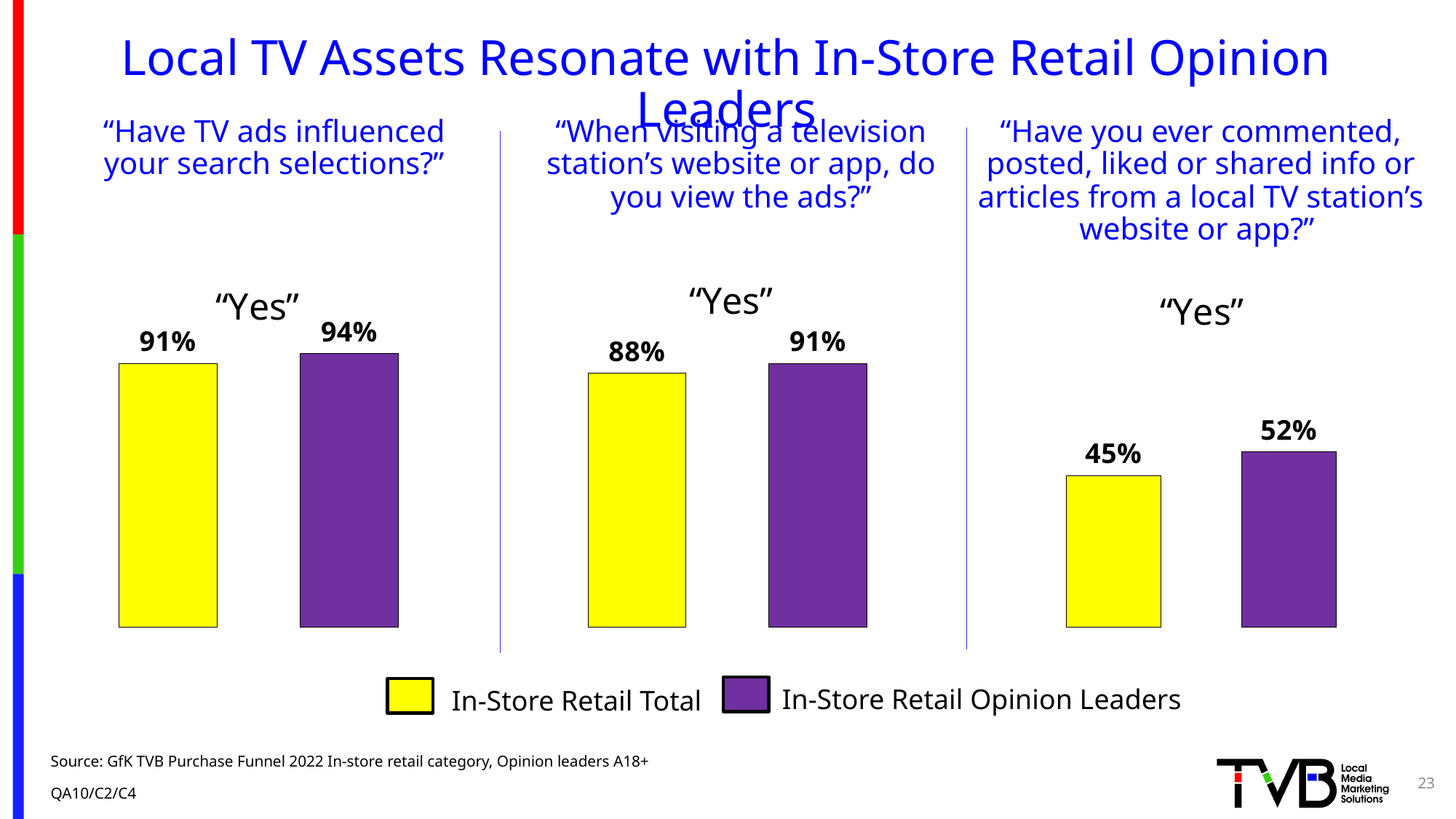
What kind of chart is used on this slide? Bar chart How many series does the legend list? 2 In the right chart ("Have you ever commented, posted, liked or shared info or articles from a local TV station's website or app?"), what is the value for In-Store Retail Opinion Leaders? 52% In the middle chart ("When visiting a television station's website or app, do you view the ads?"), which series has the larger value, In-Store Retail Total or In-Store Retail Opinion Leaders? In-Store Retail Opinion Leaders In the middle chart ("When visiting a television station's website or app, do you view the ads?"), what is the value for In-Store Retail Opinion Leaders? 91% In the middle chart ("When visiting a television station's website or app, do you view the ads?"), what is the value for In-Store Retail Total? 88% In the left chart ("Have TV ads influenced your search selections?"), what is the value for In-Store Retail Opinion Leaders? 94% In the right chart ("Have you ever commented, posted, liked or shared info or articles from a local TV station's website or app?"), what is the value for In-Store Retail Total? 45% In the left chart ("Have TV ads influenced your search selections?"), what is the value for In-Store Retail Total? 91% In the left chart ("Have TV ads influenced your search selections?"), what is the difference between the In-Store Retail Opinion Leaders value and the In-Store Retail Total value? 3% Which colour represents In-Store Retail Opinion Leaders in the legend? Purple In the right chart ("Have you ever commented, posted, liked or shared info or articles..."), what is the difference between the In-Store Retail Opinion Leaders value and the In-Store Retail Total value? 7%